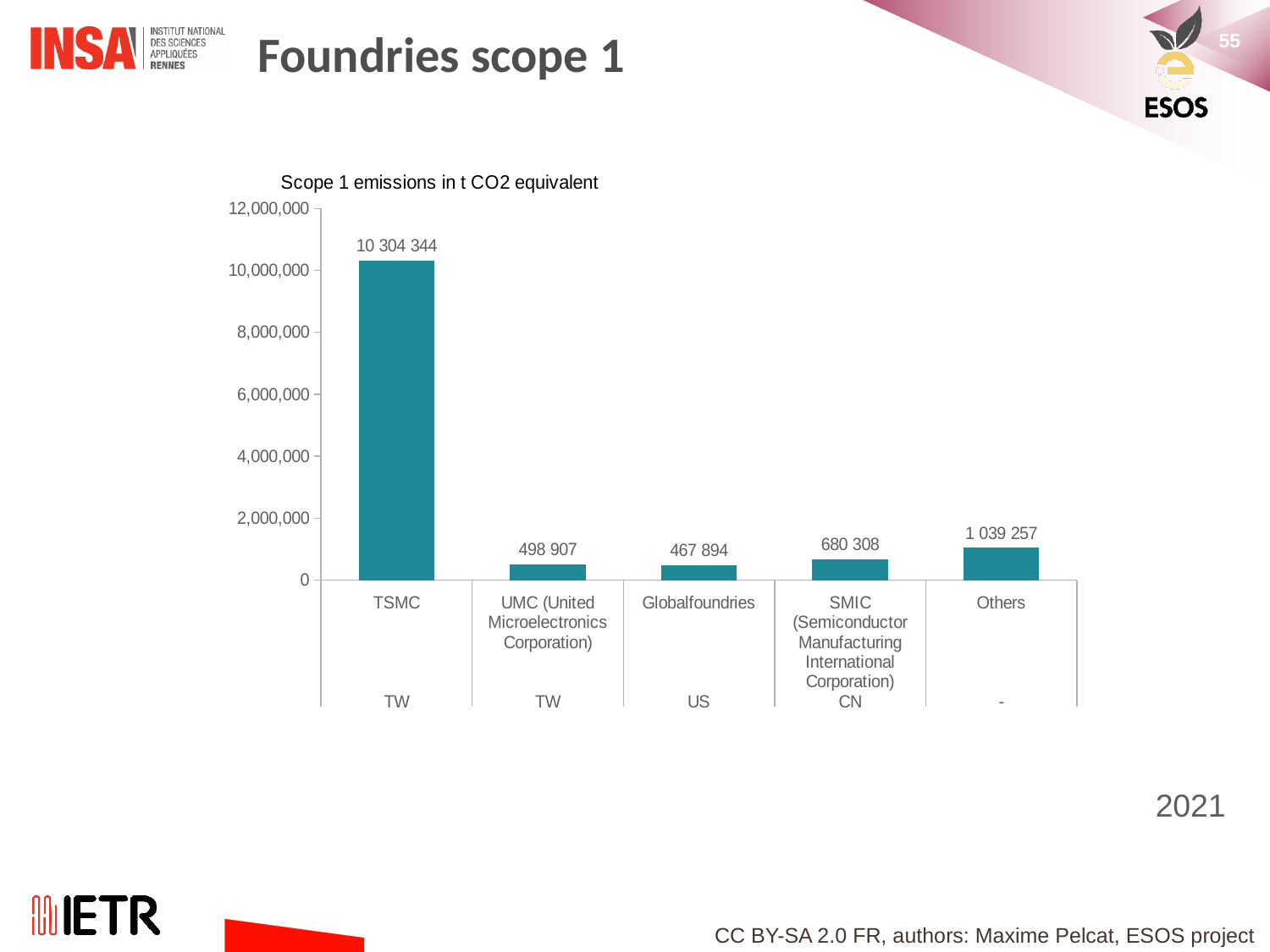
Which category has the lowest Scope 1 emissions? Globalfoundries Which foundry has the highest Scope 1 emissions? TSMC Which has higher Scope 1 emissions, SMIC or Globalfoundries? SMIC What is the Scope 1 emissions value for UMC (United Microelectronics Corporation)? 498 907 What is the Scope 1 emissions value for SMIC (Semiconductor Manufacturing International Corporation)? 680 308 How many categories are shown on the x axis of the chart? 5 What is the difference in Scope 1 emissions between TSMC and Others? 9 265 087 What is the Scope 1 emissions value for Others? 1 039 257 What kind of chart is shown on the slide? Bar chart Is the value for TSMC greater or less than 10,000,000? greater What is the Scope 1 emissions value for TSMC? 10 304 344 What is the difference in Scope 1 emissions between SMIC and UMC? 181 401